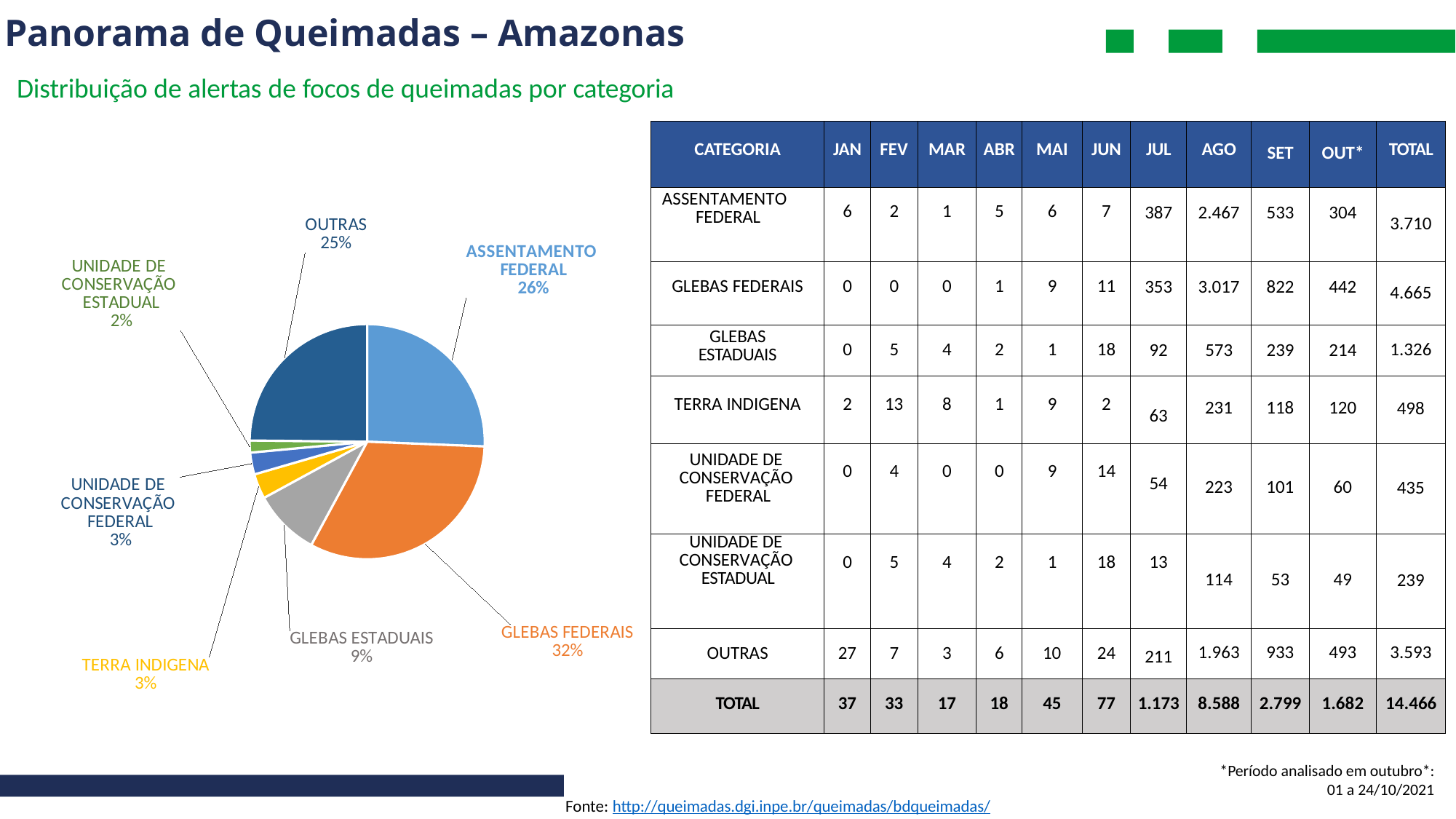
What percentage is shown for UNIDADE DE CONSERVAÇÃO ESTADUAL in the pie chart? 2% Which category has the smallest slice in the pie chart? UNIDADE DE CONSERVAÇÃO ESTADUAL What percentage is shown for OUTRAS in the pie chart? 25% What share of the pie chart does GLEBAS FEDERAIS represent? 32% What is the subtitle describing the pie chart on the slide? Distribuição de alertas de focos de queimadas por categoria What is the difference in percentage points between GLEBAS FEDERAIS and ASSENTAMENTO FEDERAL in the pie chart? 6 percentage points What kind of chart is shown on the slide? Pie chart Which category has the largest slice in the pie chart? GLEBAS FEDERAIS What percentage is shown for GLEBAS ESTADUAIS in the pie chart? 9% How many categories (slices) are shown in the pie chart? 7 Which slice is larger in the pie chart, OUTRAS or ASSENTAMENTO FEDERAL? ASSENTAMENTO FEDERAL What percentage is shown for ASSENTAMENTO FEDERAL in the pie chart? 26%